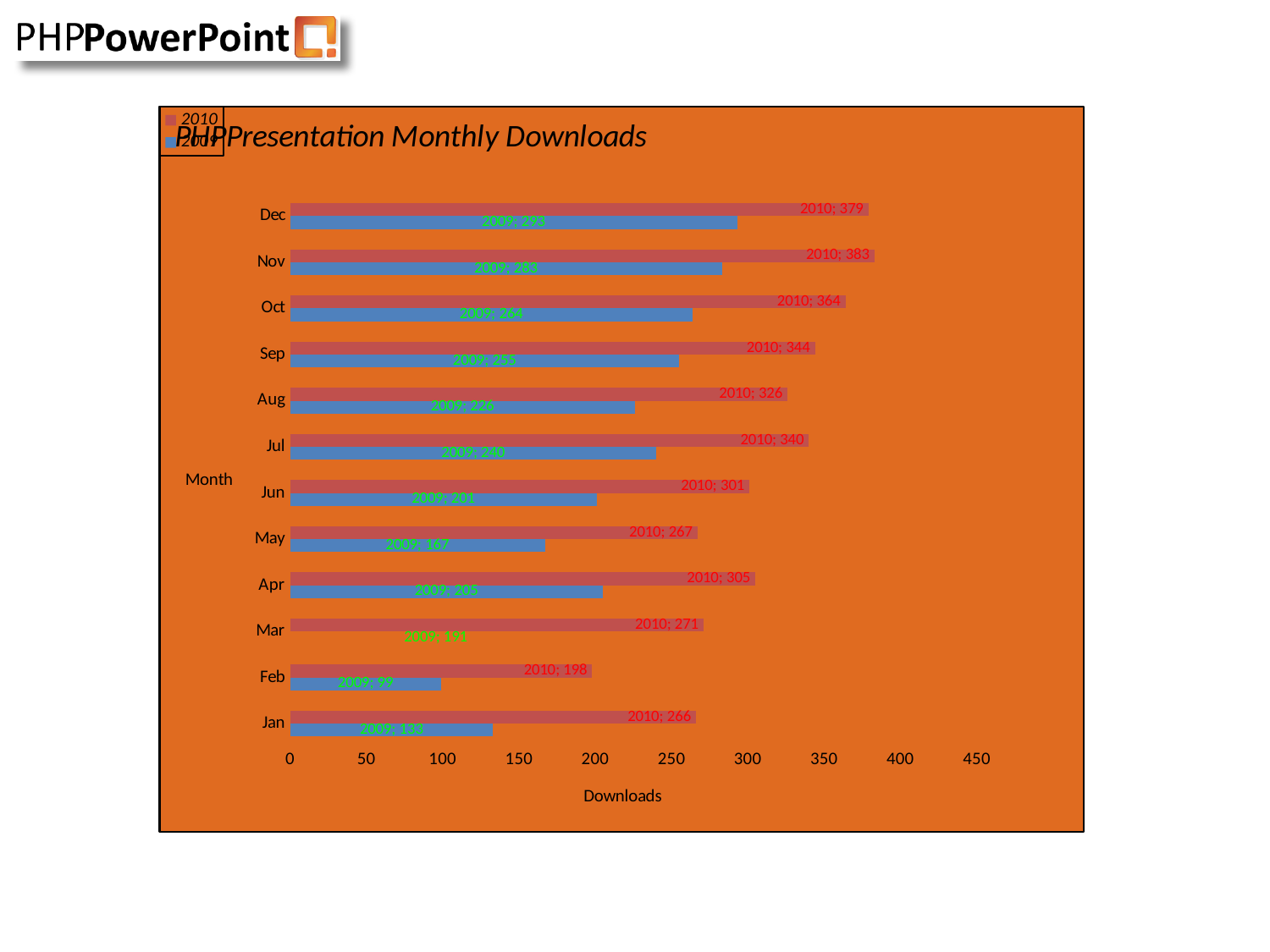
What is the 2010 value for Nov? 383 Which month has the lowest 2009 value? Feb What is the 2009 value for Jul? 240 What is the 2009 value for Feb? 99 How many months are shown on the chart? 12 Which is larger, the 2010 value for Apr or the 2010 value for Jun? Apr What is the title of the chart? PHPPresentation Monthly Downloads Is the 2009 value for Oct greater or less than 250? greater What is the difference between the 2010 and 2009 values for Dec? 86 How many series does the legend list? 2 Which month has the highest 2010 value? Nov What kind of chart is shown? bar chart